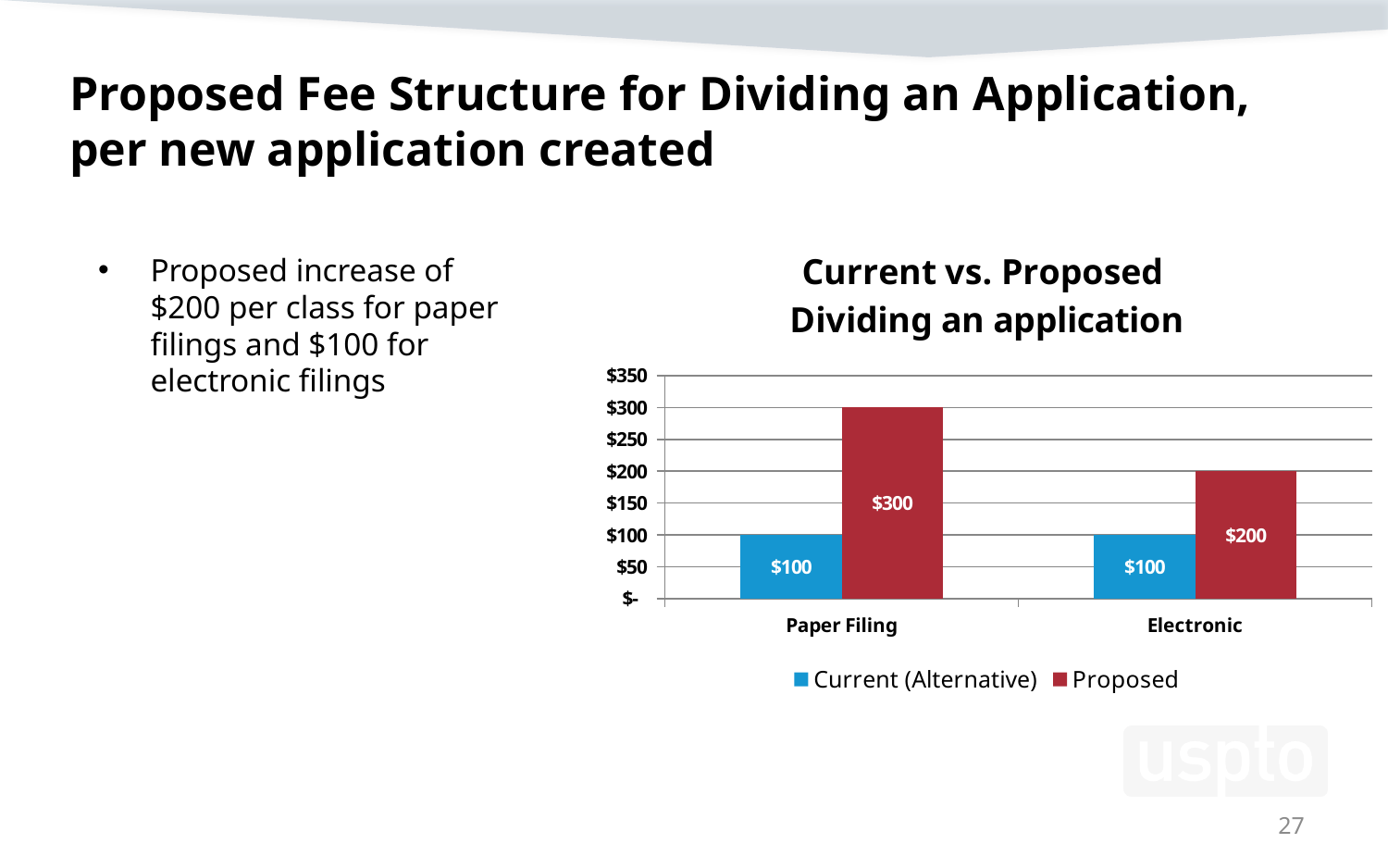
Which is larger: the Proposed fee for Electronic filing or the Current (Alternative) fee for Electronic filing? Proposed fee for Electronic filing What is the Current (Alternative) fee for Electronic filing? $100 What kind of chart is shown on the slide? Bar chart How many categories are shown on the x axis of the chart? 2 How many series does the chart legend list? 2 What is the Proposed fee for Electronic filing? $200 What is the difference between the Proposed and Current (Alternative) fees for Paper Filing? $200 What is the Current (Alternative) fee for Paper Filing? $100 Which category has the highest Proposed fee? Paper Filing What is the difference between the Proposed fee for Paper Filing and the Proposed fee for Electronic filing? $100 What is the title of the chart? Current vs. Proposed Dividing an application What is the Proposed fee for Paper Filing? $300